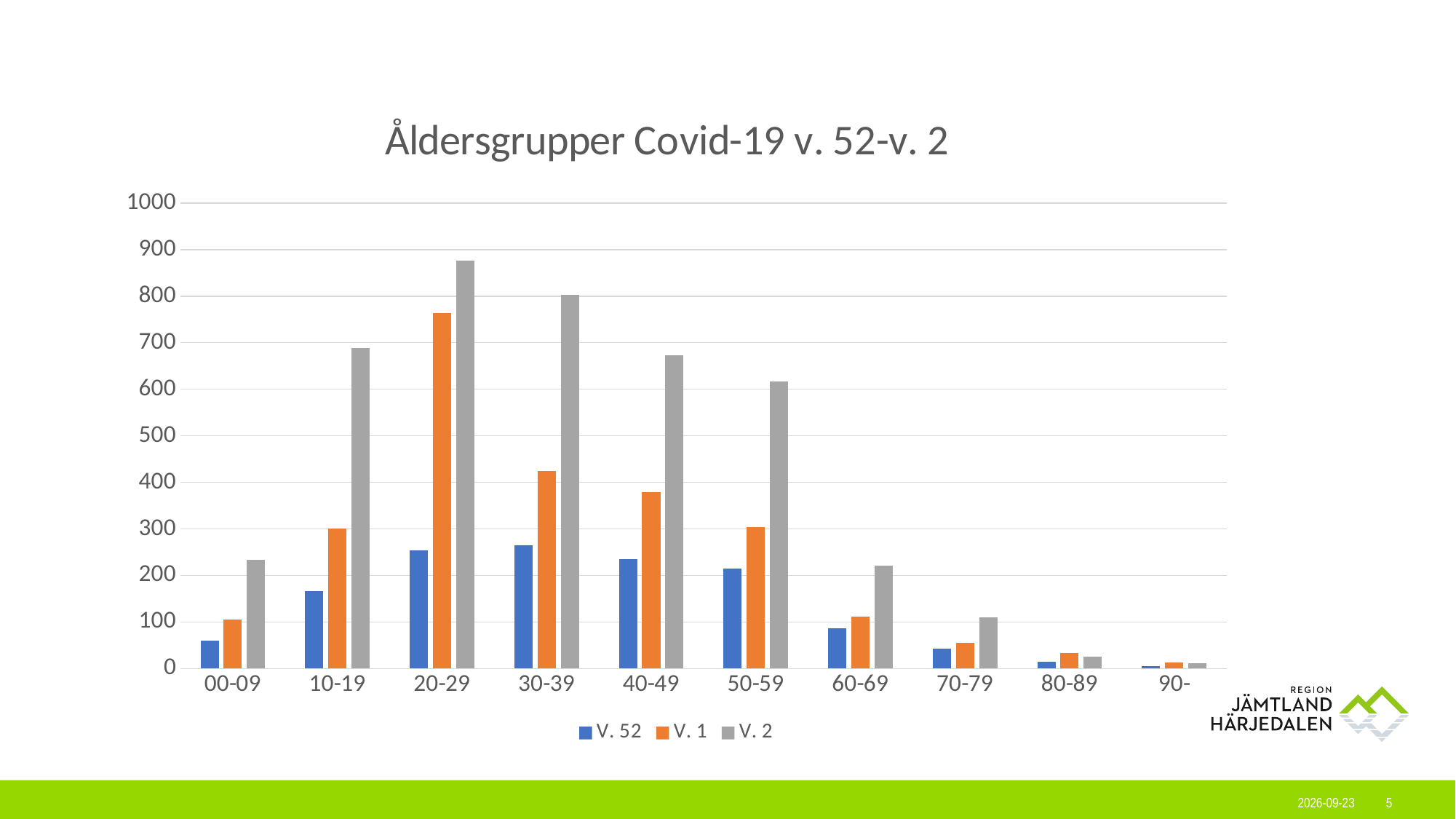
How many series does the legend list? 3 Is the V. 2 value for the 20-29 age group greater or less than 800? greater How many age-group categories are shown on the x axis? 10 Which age group has the lowest value for the V. 2 series? 90- Is the V. 1 value for the 20-29 age group greater or less than 700? greater For the 10-19 age group, which series has the larger value, V. 1 or V. 2? V. 2 Is the V. 52 value for the 10-19 age group greater or less than 200? less What kind of chart is shown on the slide? bar chart For the V. 52 series, which age group has the larger value, 00-09 or 30-39? 30-39 Which age group has the highest value for the V. 2 series? 20-29 Which age group has the highest value for the V. 1 series? 20-29 What is the title of the chart? Åldersgrupper Covid-19 v. 52-v. 2